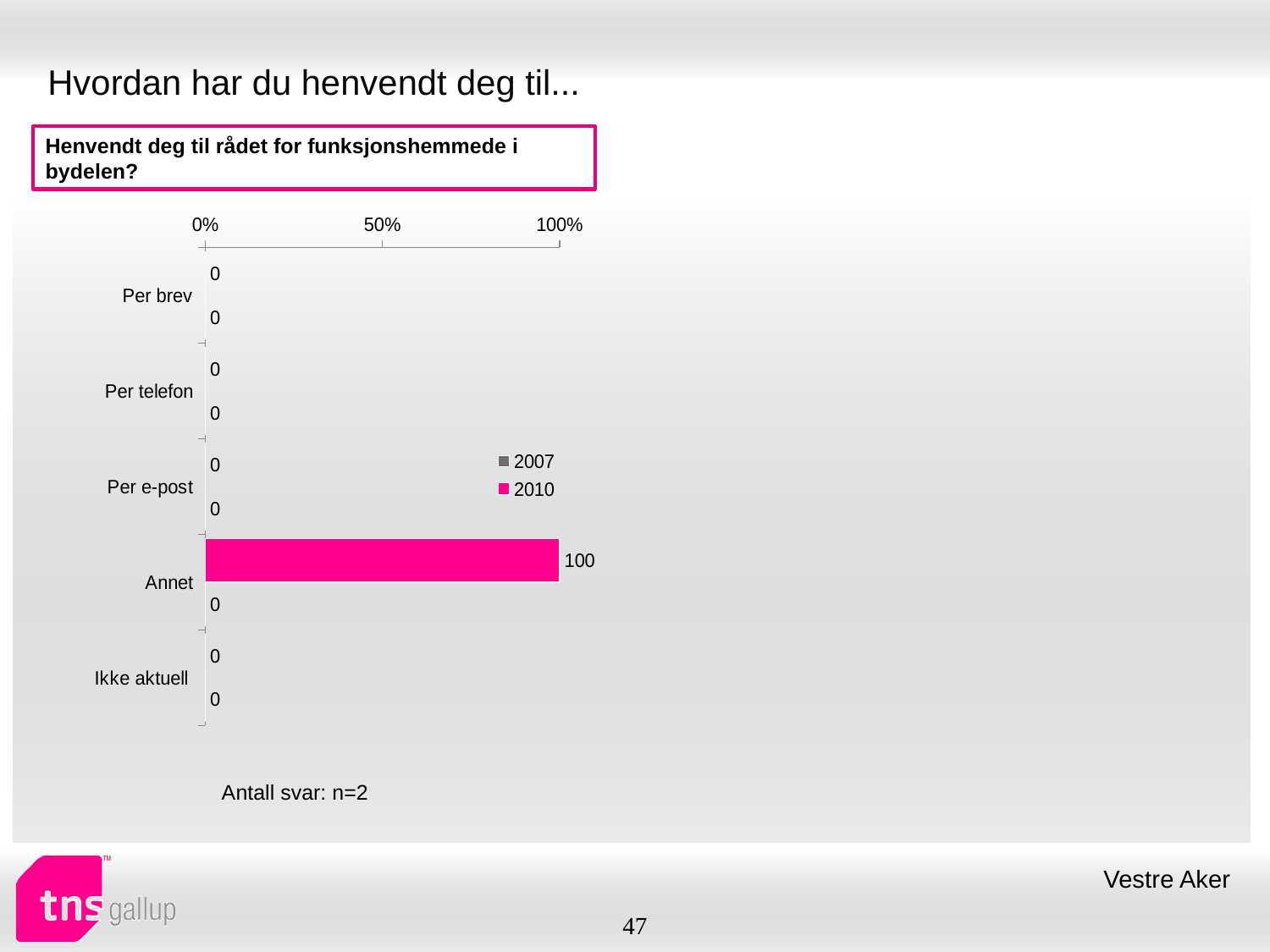
Which years are listed in the chart legend? 2007 and 2010 What value is shown for Ikke aktuell? 0 Which is larger, the value for Annet or the value for Per telefon? Annet What is the value of the only non-zero bar, shown for Annet? 100 What value is shown for Per brev? 0 How many responses (Antall svar) does the slide report for this chart? n=2 Which category has the highest value on the chart? Annet How many series does the legend list? 2 How many categories are shown on the chart? 5 What kind of chart is shown on the slide? Bar chart Is the value of the bar for Annet greater or less than 50%? greater What is the difference between the value for Annet (100) and the value for Per e-post (0)? 100